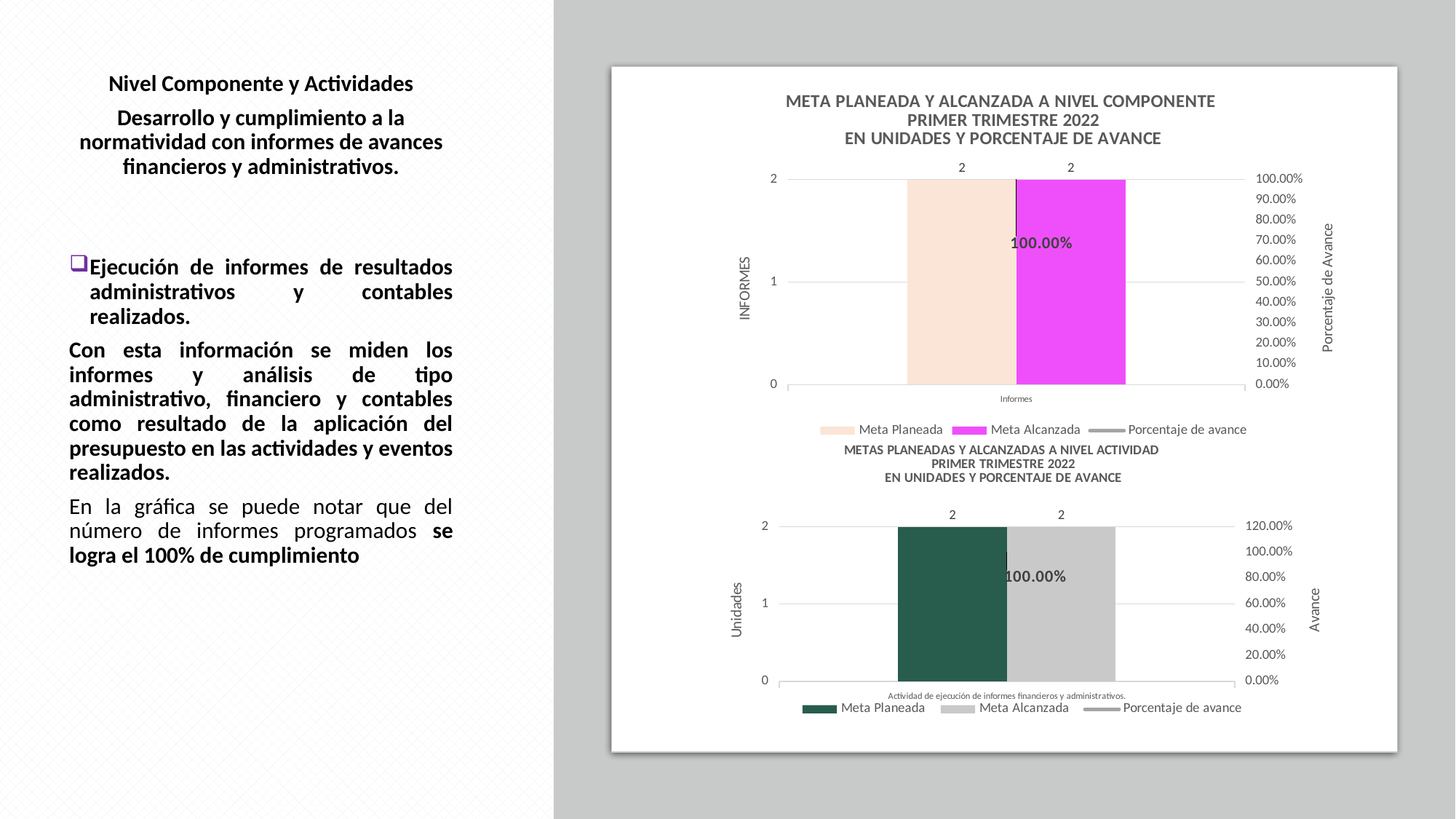
In the bottom chart (Metas planeadas y alcanzadas a nivel actividad), how many categories are shown on the x axis? 1 In the top chart (Meta planeada y alcanzada a nivel componente), what kind of chart is used for Meta Planeada and Meta Alcanzada? Bar chart In the bottom chart (Metas planeadas y alcanzadas a nivel actividad), what is the highest value shown on the right-hand Avance axis? 120.00% In the top chart (Meta planeada y alcanzada a nivel componente), what is the difference between Meta Planeada and Meta Alcanzada? 0 In the top chart (Meta planeada y alcanzada a nivel componente), what is the value of Meta Planeada for Informes? 2 In the bottom chart (Metas planeadas y alcanzadas a nivel actividad), what Porcentaje de avance is labelled on the chart? 100.00% In the bottom chart (Metas planeadas y alcanzadas a nivel actividad), what is the value of Meta Alcanzada? 2 In the top chart (Meta planeada y alcanzada a nivel componente), what Porcentaje de avance is labelled on the chart? 100.00% In the top chart (Meta planeada y alcanzada a nivel componente), how many series does the legend list? 3 In the top chart (Meta planeada y alcanzada a nivel componente), what is the value of Meta Alcanzada for Informes? 2 In the top chart (Meta planeada y alcanzada a nivel componente), what is the label of the left vertical axis? INFORMES In the bottom chart (Metas planeadas y alcanzadas a nivel actividad), what is the value of Meta Planeada? 2